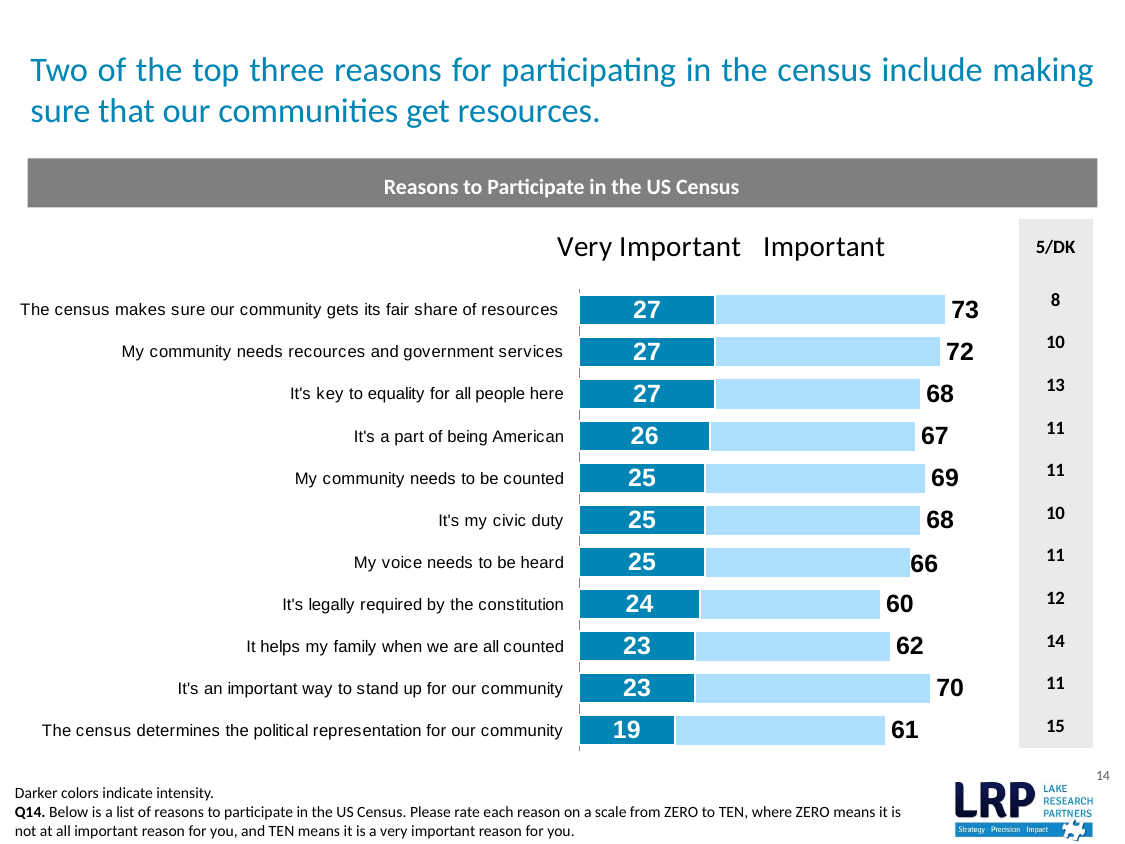
How many reasons are listed in the chart? 11 How many series does the chart show in its legend? 2 What kind of chart is shown on the slide? Stacked bar chart Which reason has the lowest total value shown at the end of its bar? It's legally required by the constitution Which has a larger total value: 'My community needs to be counted' or 'My voice needs to be heard'? My community needs to be counted Which reason has the highest total value shown at the end of its bar? The census makes sure our community gets its fair share of resources What is the 5/DK value for 'It helps my family when we are all counted'? 14 What is the title of the chart? Reasons to Participate in the US Census Which reason has the lowest 'Very Important' value? The census determines the political representation for our community What is the 'Very Important' value for 'It's a part of being American'? 26 What is the total value shown at the end of the bar for 'The census makes sure our community gets its fair share of resources'? 73 What is the difference between the total values for 'It's an important way to stand up for our community' and 'It's legally required by the constitution'? 10